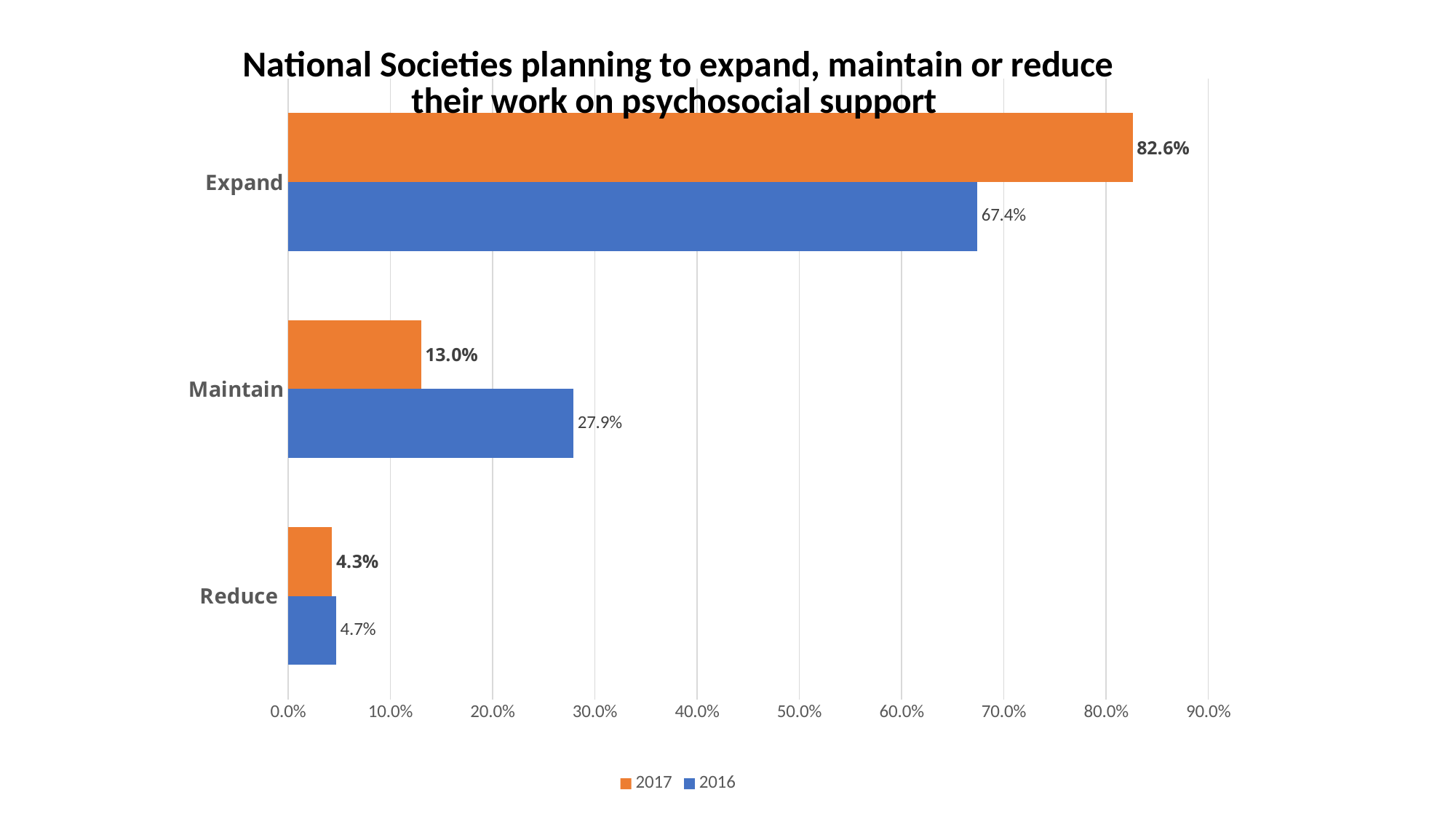
What is the value for Expand in 2017? 82.6% What is the difference between the 2016 and 2017 values for Maintain? 14.9% Which category has the highest value for 2016? Expand What is the value for Maintain in 2016? 27.9% Which series is shown in orange? 2017 Which is larger for Maintain, the 2017 value or the 2016 value? 2016 What is the difference between the 2017 and 2016 values for Expand? 15.2% What is the value for Reduce in 2017? 4.3% What kind of chart is this? Bar chart How many categories are shown on the chart? 3 How many series does the legend list? 2 Which category has the lowest value for 2017? Reduce